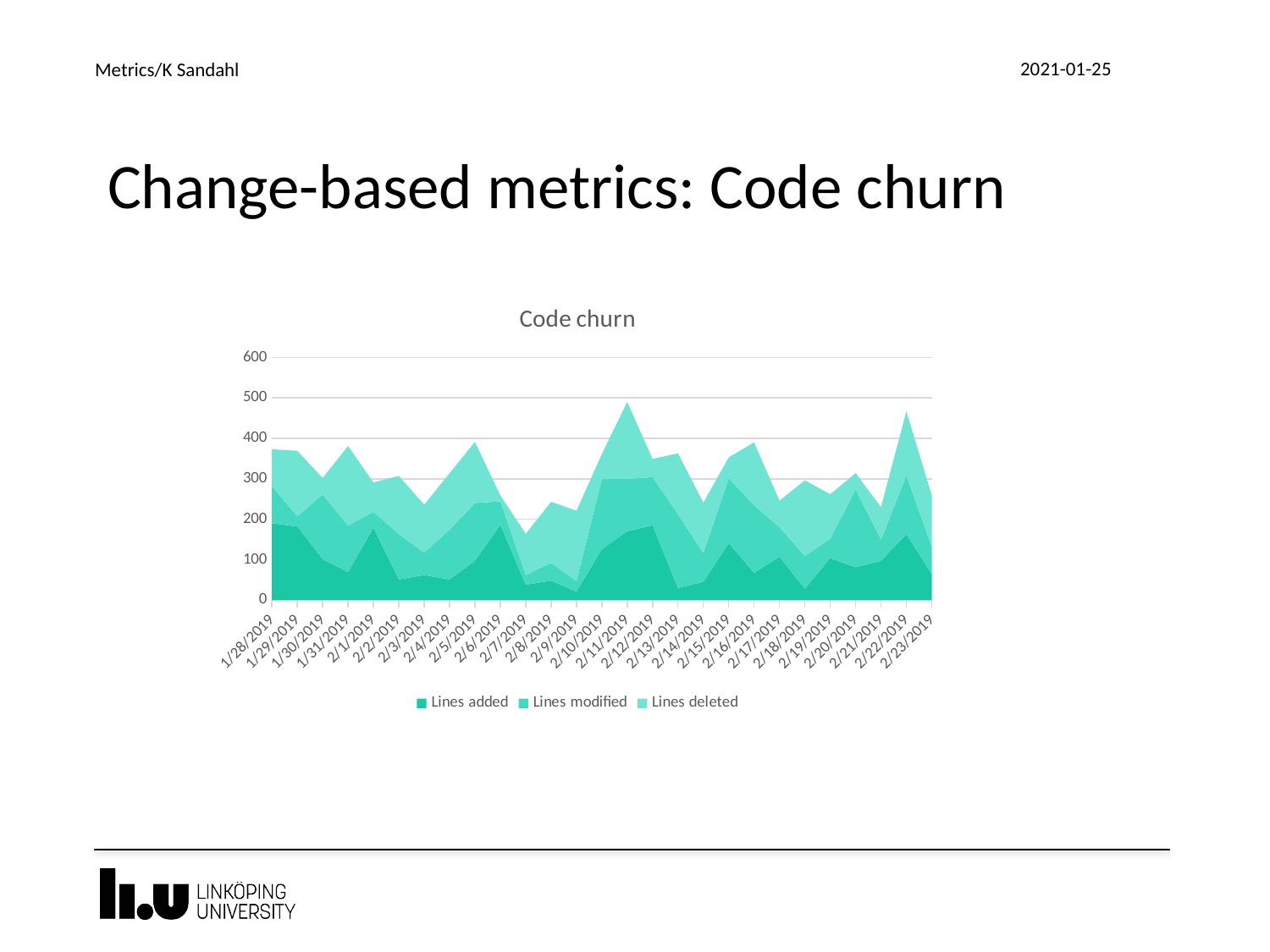
Is the total code churn on 2/11/2019 greater or less than 400? greater On which date is the total code churn lowest? 2/7/2019 How many series does the legend list? 3 On which date is the value for Lines added lowest? 2/9/2019 What is the title of the chart? Code churn Which date has the larger total code churn, 2/11/2019 or 2/7/2019? 2/11/2019 On which date is the total code churn highest? 2/11/2019 Which series are listed in the legend? Lines added, Lines modified, Lines deleted Is the value for Lines added on 2/12/2019 greater or less than 100? greater How many dates are shown on the x axis? 27 What kind of chart is shown on the slide? Stacked area chart Is the total code churn on 2/7/2019 greater or less than 200? less